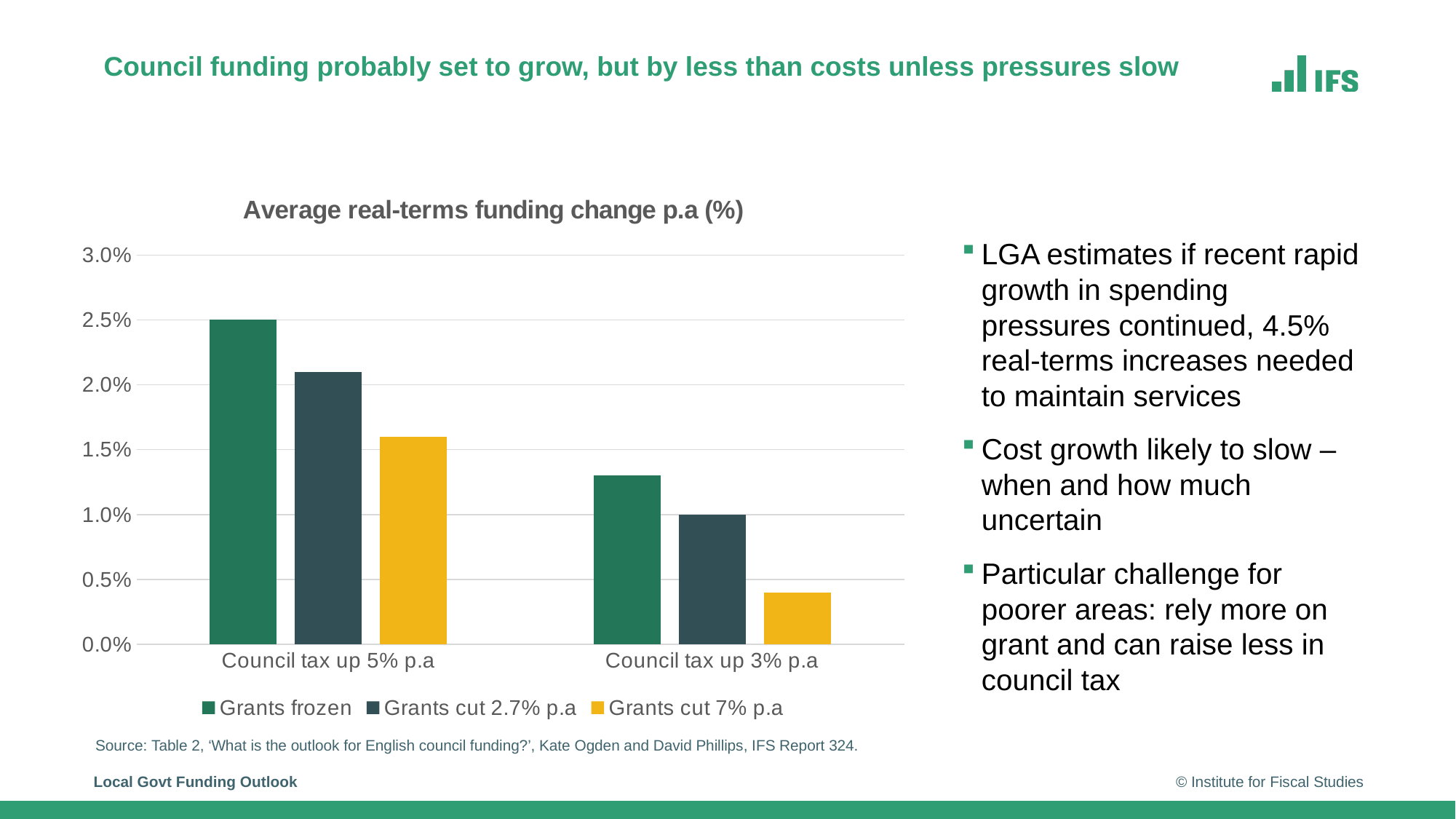
What kind of chart is shown on the slide? bar chart What is the value for Grants cut 2.7% p.a under Council tax up 3% p.a? 1.0% Which series has the highest value under Council tax up 3% p.a? Grants frozen What is the title of the chart? Average real-terms funding change p.a (%) Is the value for Grants cut 2.7% p.a under Council tax up 5% p.a greater or less than 2.0%? greater Which series is shown in yellow in the legend? Grants cut 7% p.a How many categories are shown on the x axis? 2 Is the value for Grants cut 7% p.a under Council tax up 5% p.a greater or less than 1.5%? greater Which is larger: Grants frozen under Council tax up 3% p.a or Grants cut 7% p.a under Council tax up 5% p.a? Grants cut 7% p.a under Council tax up 5% p.a What is the value for Grants frozen under Council tax up 5% p.a? 2.5% Is the value for Grants cut 7% p.a under Council tax up 3% p.a greater or less than 0.5%? less How many series does the legend list? 3